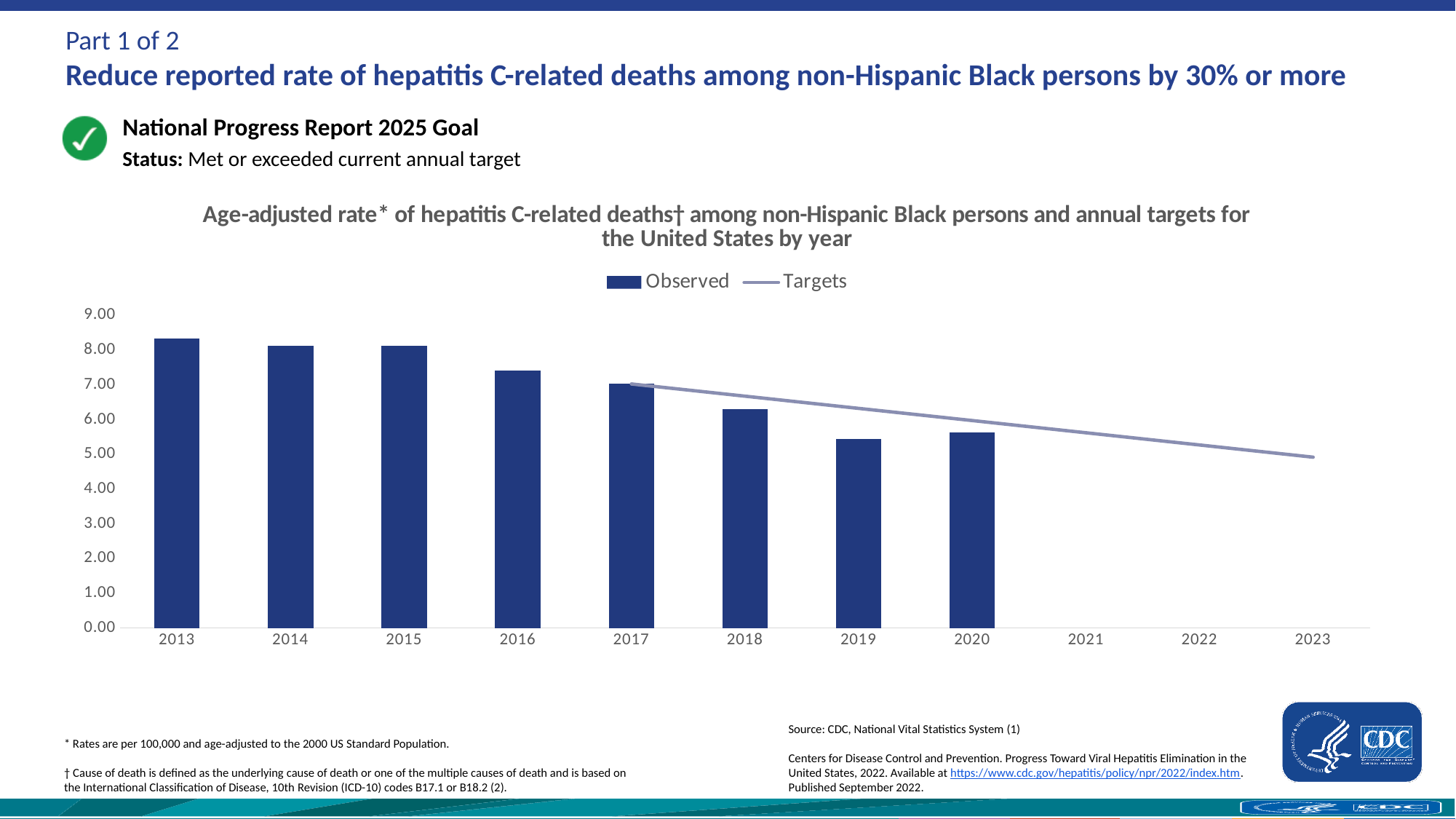
Is the Observed value for 2020 greater or less than 6.00? less How many series does the chart legend list? 2 How many years have an Observed bar plotted in the chart? 8 Do the Observed values generally rise or fall from 2013 to 2020? Fall Is the Observed value for 2016 greater or less than 7.00? greater Is the Observed value for 2013 greater or less than 8.00? greater Which year has the highest Observed rate in the chart? 2013 What are the two series named in the chart legend? Observed and Targets What kind of chart is shown on the slide? Bar chart (with a line for targets) Which is larger, the Observed value for 2016 or for 2018? 2016